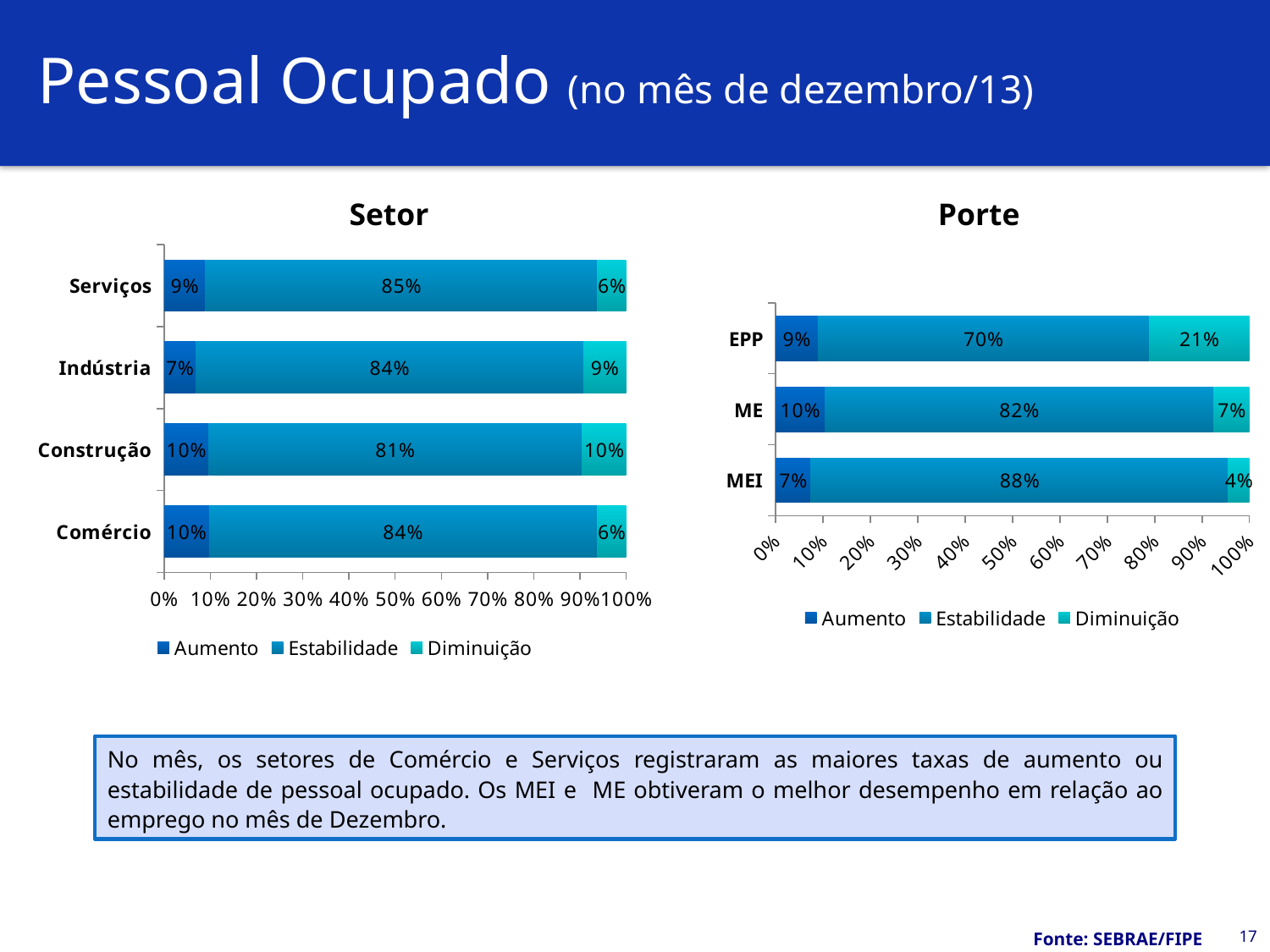
How many series does the legend of the Porte chart list? 3 In the Setor chart, what is the Diminuição value for Indústria? 9% In the Setor chart, how many categories are shown? 4 In the Porte chart, which is larger: the Diminuição value for EPP or for ME? EPP What type of chart is the Setor chart? Stacked bar chart In the Porte chart, what is the difference between the Estabilidade values for MEI and EPP? 18% In the Porte chart, what is the Diminuição value for EPP? 21% In the Setor chart, what is the Estabilidade value for Serviços? 85% In the Setor chart, which category has the lowest Estabilidade value? Construção In the Porte chart, what is the Aumento value for ME? 10% In the Porte chart, which category has the highest Estabilidade value? MEI In the Setor chart, what is the difference between the Estabilidade values for Serviços and Construção? 4%